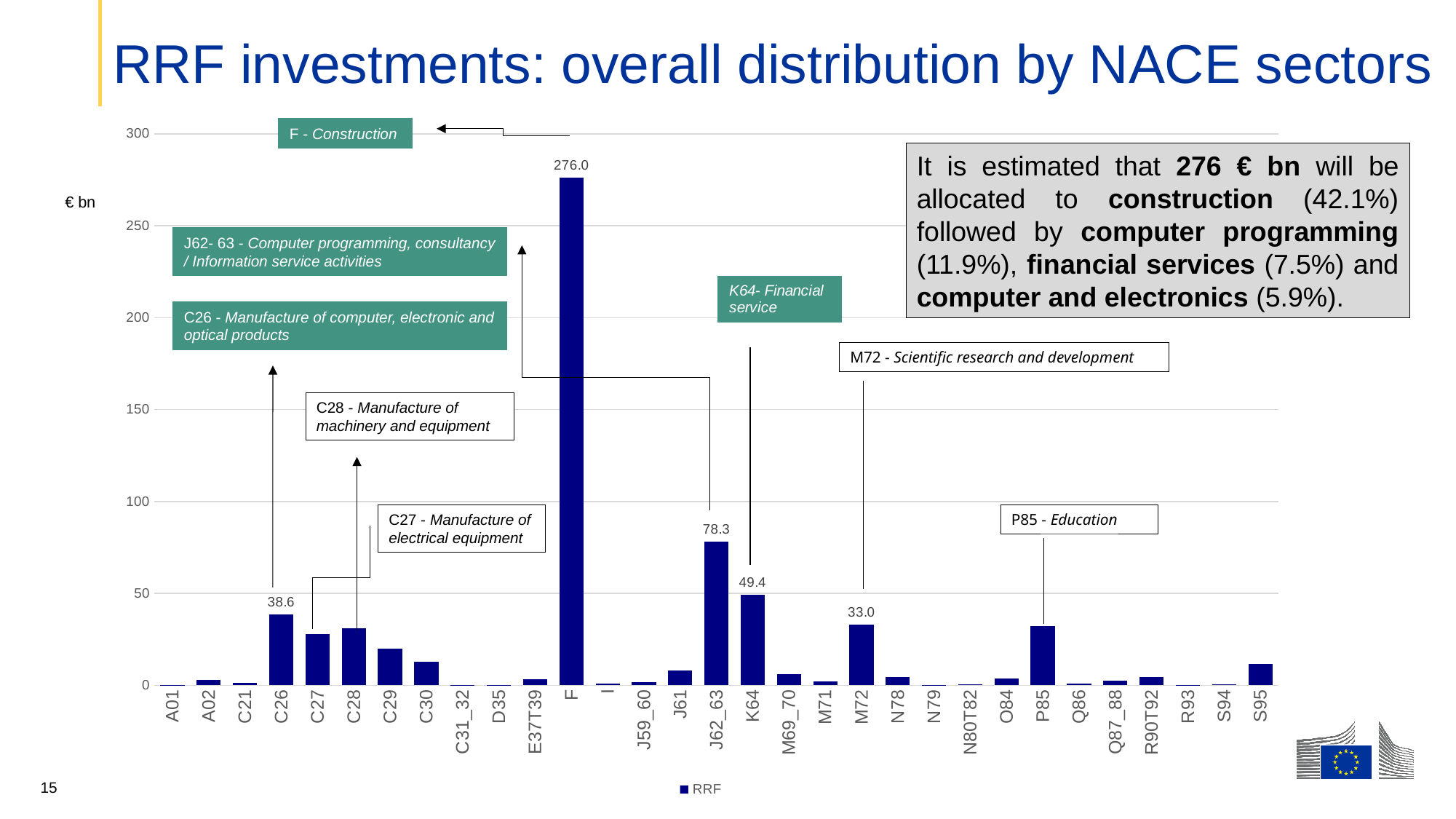
What is the value for K64? 49.4 Is the value for P85 greater or less than 50? less What is the difference between the values for F and J62_63? 197.7 Which is larger, the value for C26 or the value for M72? C26 How many categories are shown on the x axis? 31 Which category has the highest value? F What is the difference between the values for K64 and C26? 10.8 What is the value for C26? 38.6 What is the value for J62_63? 78.3 What is the value for M72? 33.0 What kind of chart is shown on the slide? bar chart What is the value for F (Construction)? 276.0